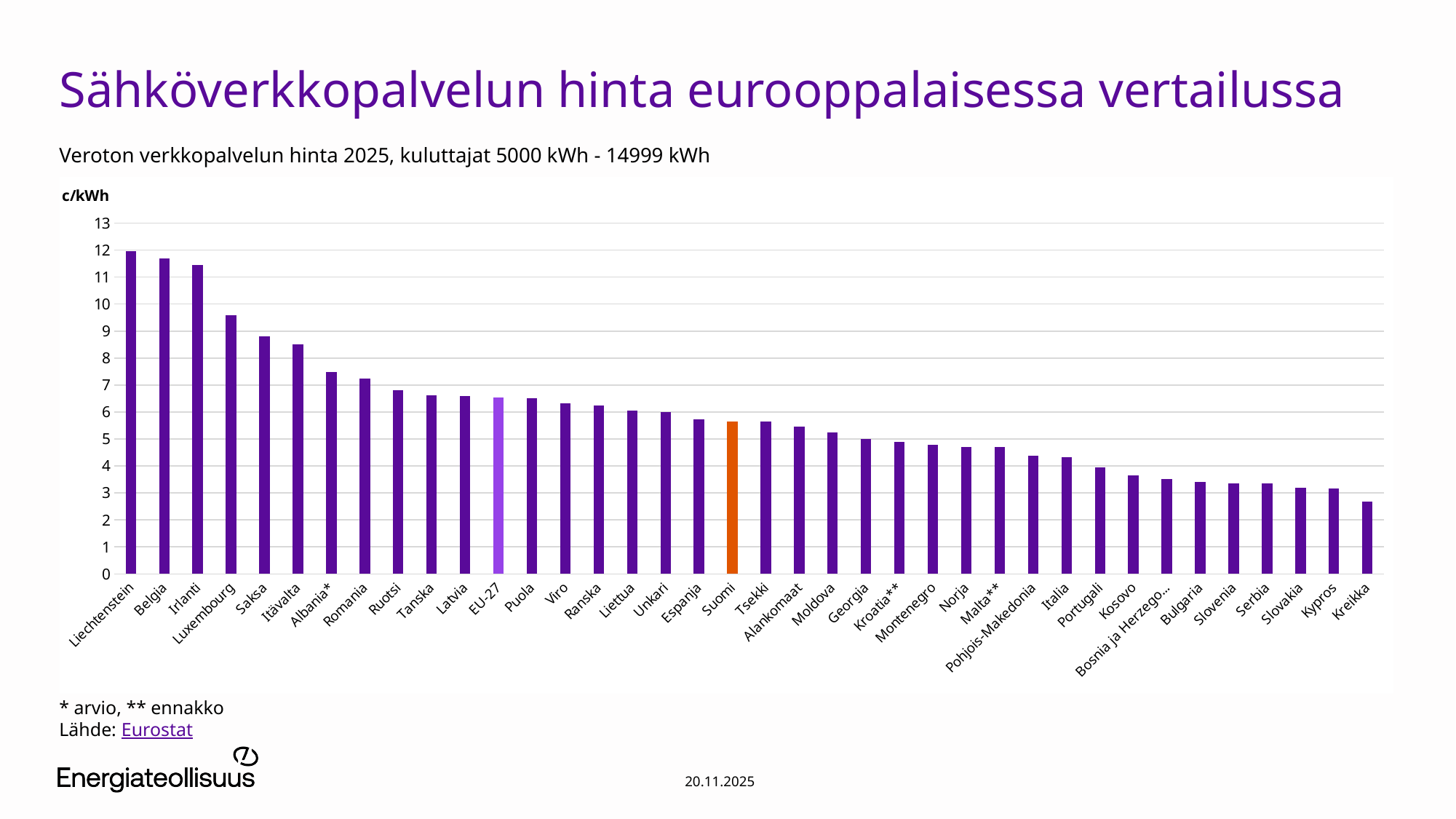
What kind of chart is shown on the slide? bar chart Is the value for Kreikka greater or less than 3 c/kWh? less Which country has the highest network service price in the chart? Liechtenstein Is the value for Suomi greater or less than 5 c/kWh? greater Which bar is highlighted in orange in the chart? Suomi Is the value for Liechtenstein greater or less than 11 c/kWh? greater Which country has the lowest network service price in the chart? Kreikka Which has a higher value, Saksa or Itävalta? Saksa Which has a higher value, Suomi or EU-27? EU-27 How many bars (countries and EU-27) are shown in the chart? 38 Do the values rise or fall from left to right along the x axis? fall